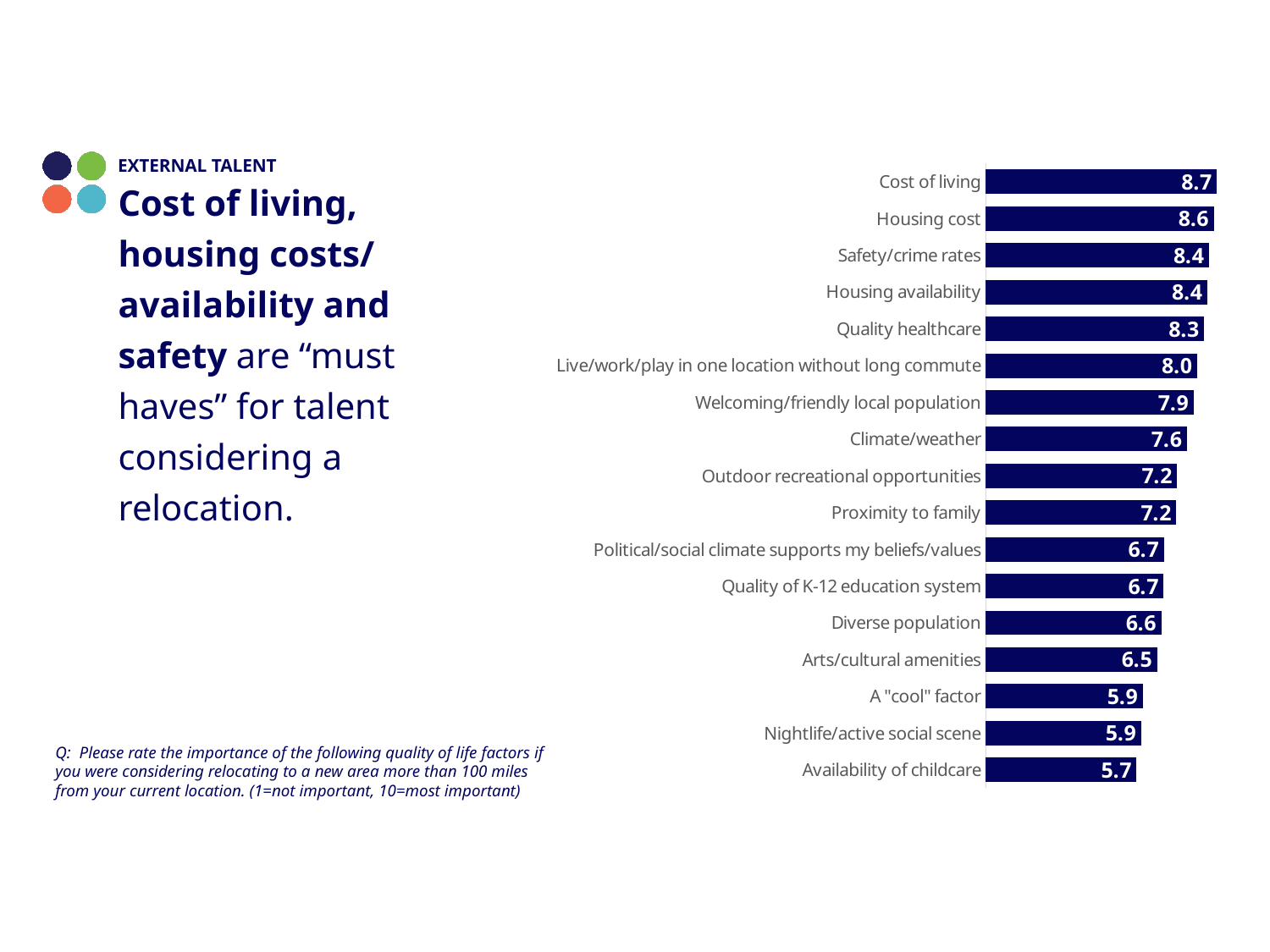
Which is larger, the value for Diverse population or the value for Welcoming/friendly local population? Welcoming/friendly local population What is the value for Climate/weather? 7.6 What is the value for Cost of living? 8.7 What is the value for Availability of childcare? 5.7 What is the value for Quality healthcare? 8.3 What kind of chart is shown on the slide? Bar chart What is the difference between the values for Cost of living and Availability of childcare? 3.0 How many categories are shown in the chart? 17 Which category has the highest value? Cost of living What is the value for Live/work/play in one location without long commute? 8.0 What is the difference between the values for Housing cost and Climate/weather? 1.0 Which category has the lowest value? Availability of childcare